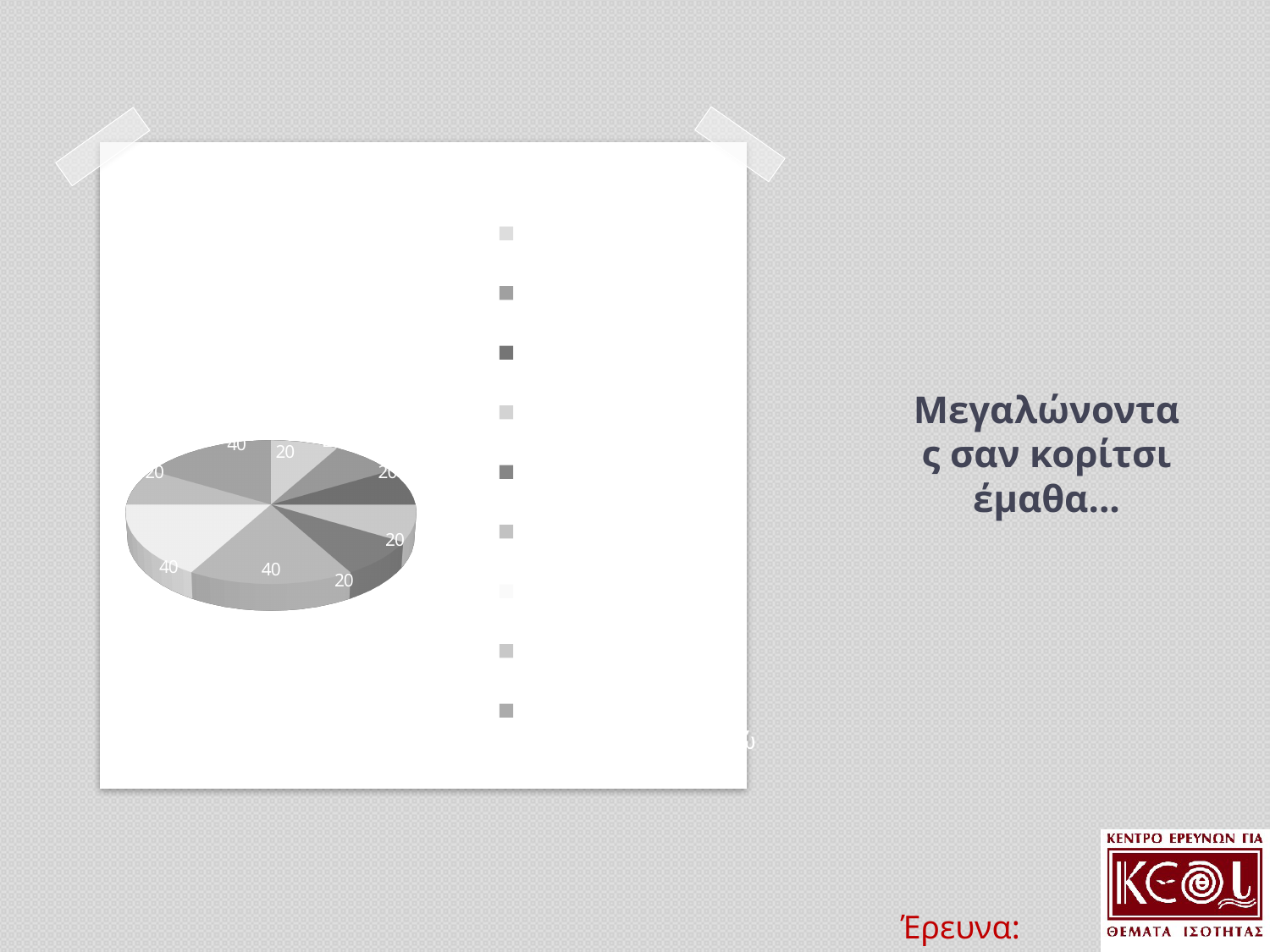
What kind of chart is shown on the slide? pie chart Which two distinct values appear as data labels on the pie chart? 20 and 40 Is the pie chart drawn in 3D or flat 2D? 3D What is the difference between the largest and smallest data label values on the pie chart? 20 How many entries does the legend to the right of the pie chart show? 9 What is the smallest value printed as a data label on the pie chart? 20 What is the largest value printed as a data label on the pie chart? 40